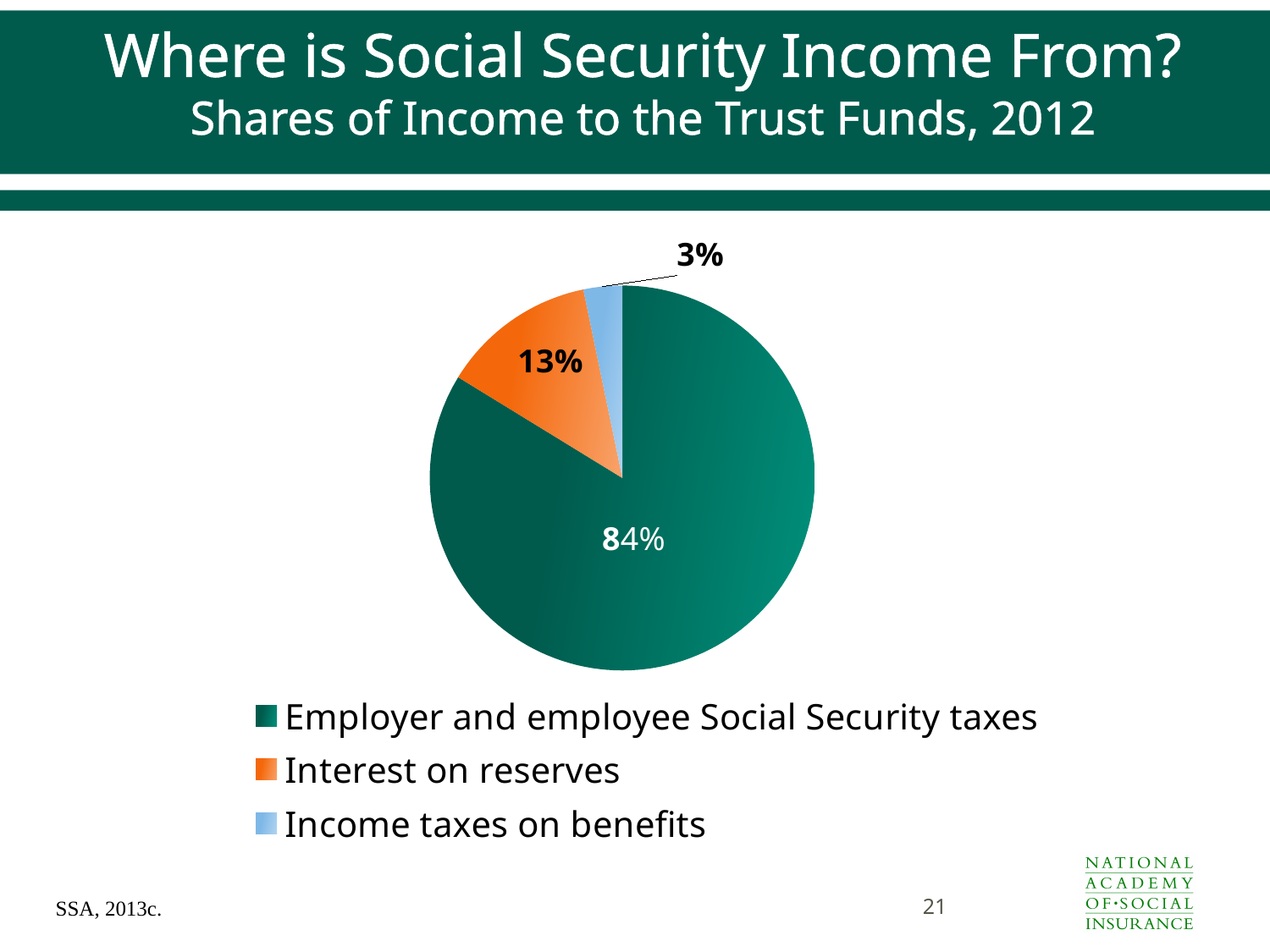
Which source provides the largest share of income to the trust funds? Employer and employee Social Security taxes What share of income to the trust funds comes from income taxes on benefits? 3% What share of income to the trust funds comes from interest on reserves? 13% How many percentage points larger is the share from employer and employee Social Security taxes than the share from interest on reserves? 71 percentage points What share of income to the trust funds comes from employer and employee Social Security taxes? 84% Which source provides the smallest share of income to the trust funds? Income taxes on benefits Which is larger: the share from interest on reserves or the share from income taxes on benefits? Interest on reserves What year does the chart's subtitle say the shares of income are for? 2012 What kind of chart is shown on the slide? Pie chart How many slices does the pie chart have? 3 What colour is the slice for interest on reserves? Orange How many percentage points larger is the share from interest on reserves than the share from income taxes on benefits? 10 percentage points